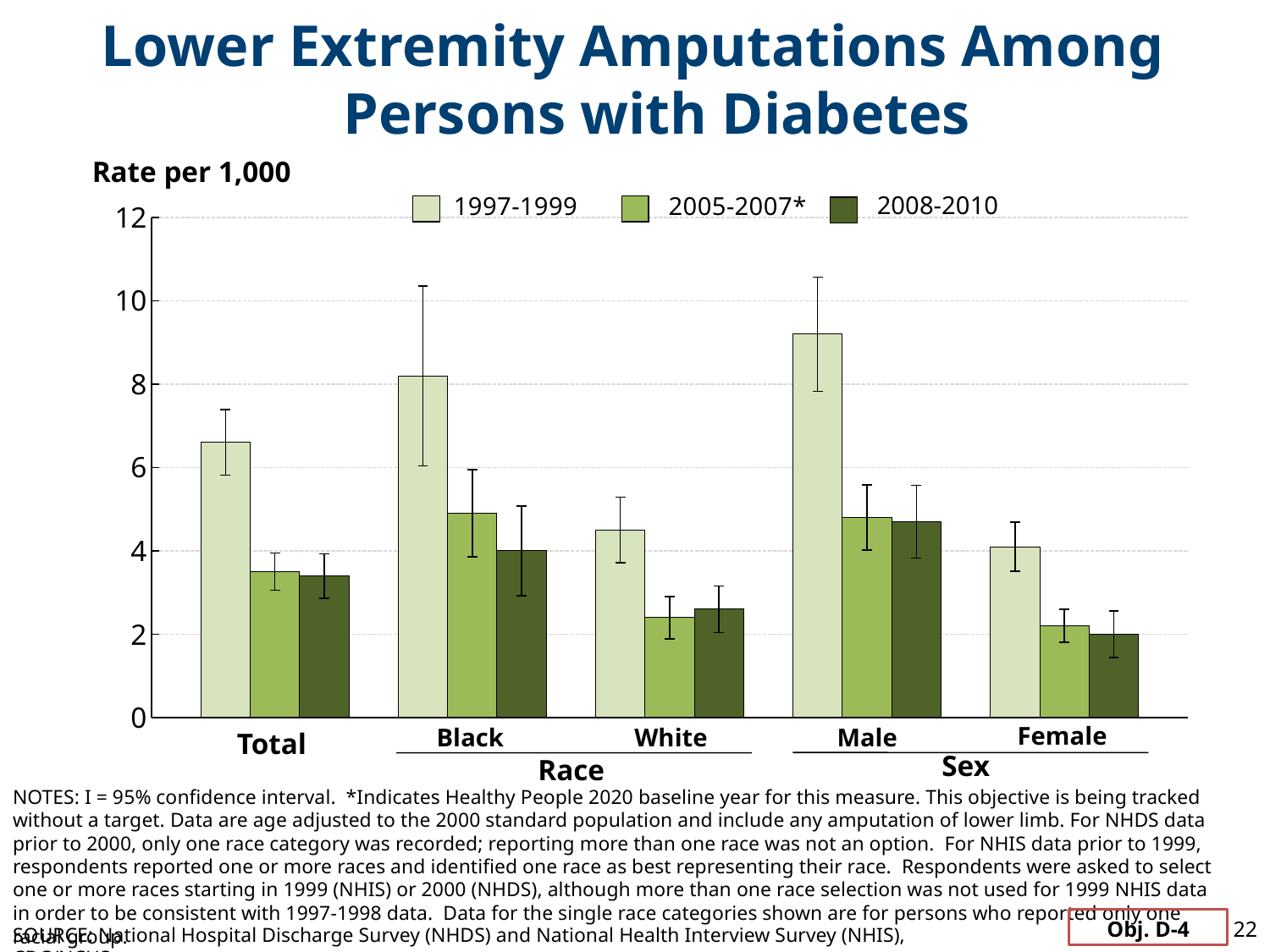
Is the 2008-2010 value for Female greater or less than 4? less Which category has the lowest 2008-2010 bar? Female What kind of chart is shown on the slide? bar chart How many series does the legend list? 3 Which category has the highest 1997-1999 bar? Male Which is larger, the 2008-2010 value for Male or the 2008-2010 value for Female? Male Which is larger, the 1997-1999 value for Black or the 1997-1999 value for White? Black How many categories are shown along the x axis? 5 Is the 2005-2007* value for White greater or less than 4? less What unit is the y axis measured in, according to the label above the chart? Rate per 1,000 Is the 1997-1999 value for Total greater or less than 6? greater